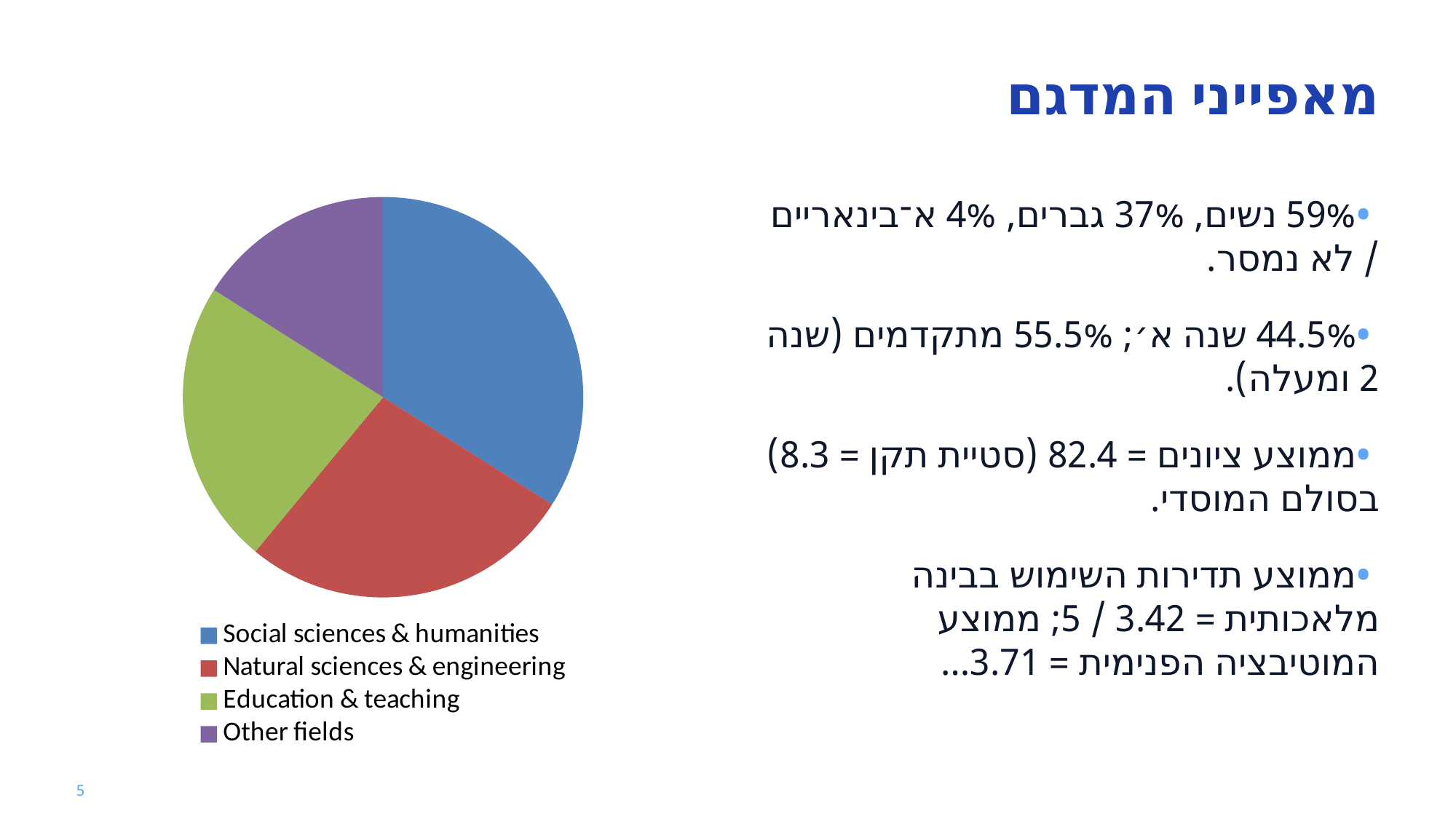
Which category has the largest slice in the pie chart? Social sciences & humanities Which slice is larger: Social sciences & humanities or Other fields? Social sciences & humanities Which slice is larger: Natural sciences & engineering or Other fields? Natural sciences & engineering What kind of chart is shown on the slide? Pie chart How many slices does the pie chart have? 4 Which slice is larger: Social sciences & humanities or Natural sciences & engineering? Social sciences & humanities How many entries does the legend of the pie chart list? 4 Which category is shown in blue in the pie chart? Social sciences & humanities Which category has the smallest slice in the pie chart? Other fields Which colour represents Education & teaching in the pie chart? Green